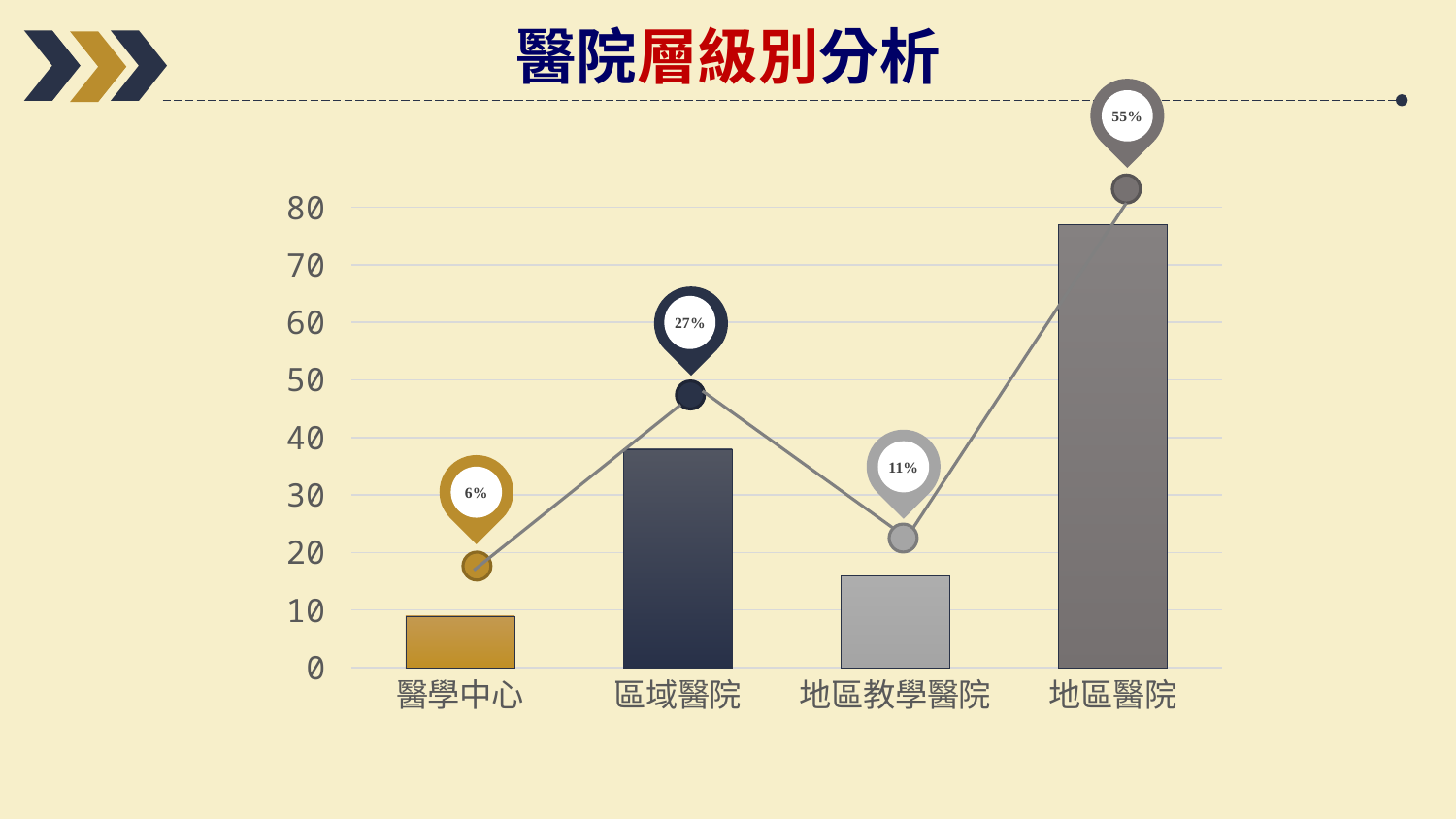
What percentage label is shown above 地區教學醫院? 11% Which bar is taller, 區域醫院 or 地區教學醫院? 區域醫院 What percentage label is shown above 醫學中心? 6% What is the title of the chart on the slide? 醫院層級別分析 Is the bar value for 地區醫院 greater or less than 70? greater How many categories are shown on the x axis of the chart? 4 Which category has the tallest bar? 地區醫院 Which category has the shortest bar? 醫學中心 What percentage label is shown above 地區醫院? 55% What kind of chart is shown on the slide? bar chart What percentage label is shown above 區域醫院? 27% Is the bar value for 區域醫院 greater or less than 40? less